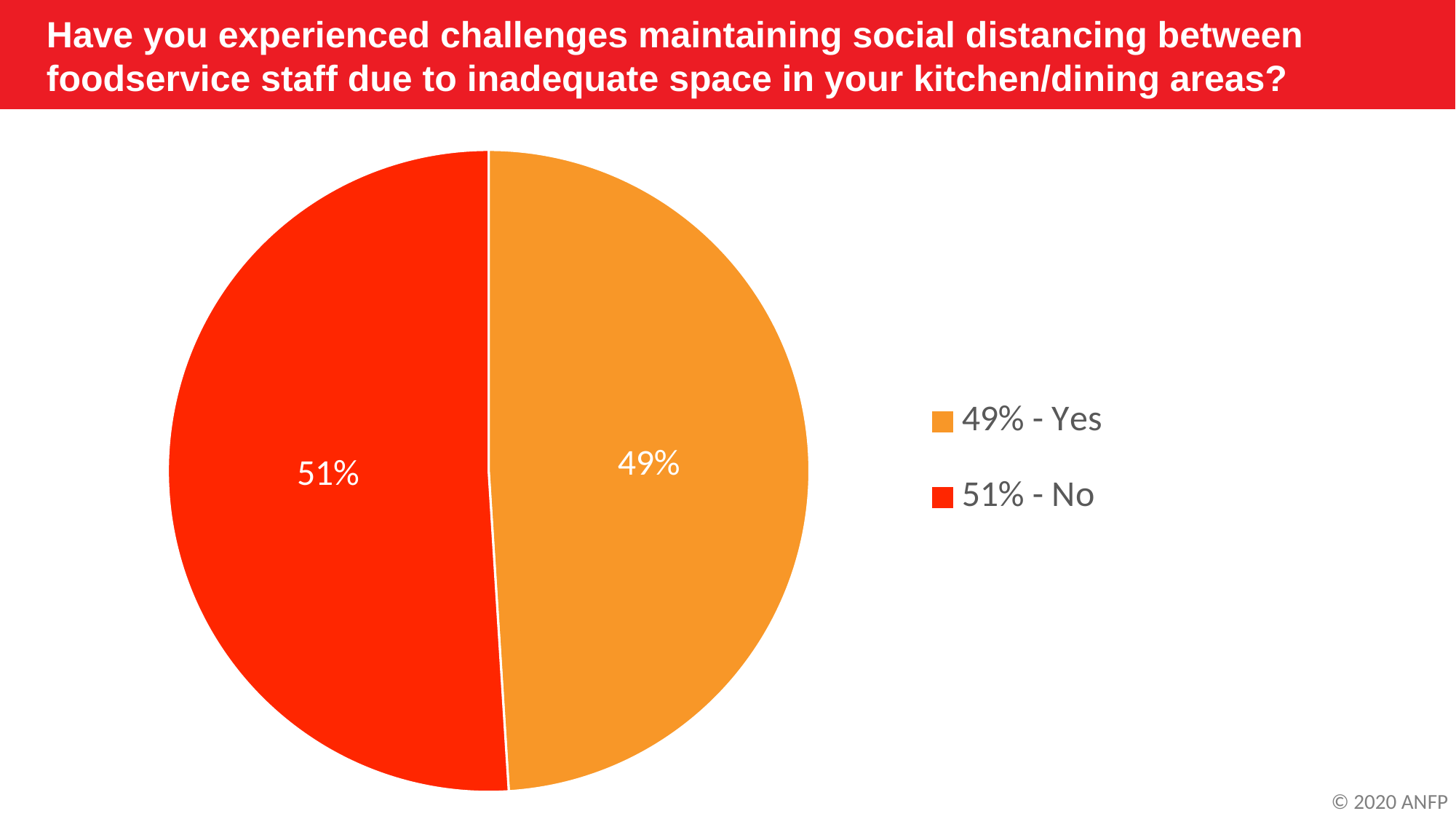
What colour is the slice representing No? red What kind of chart is shown on the slide? pie chart What percentage of respondents answered No? 51% How many slices does the pie chart have? 2 What colour is the slice representing Yes? orange What is the total of the two slices shown in the pie chart? 100% What is the difference in percentage points between the No and Yes responses? 2 Which response has the larger share of the pie? No Which response has the smaller share of the pie? Yes How many entries does the legend list? 2 Is the share for Yes larger or smaller than the share for No? smaller What percentage of respondents answered Yes? 49%